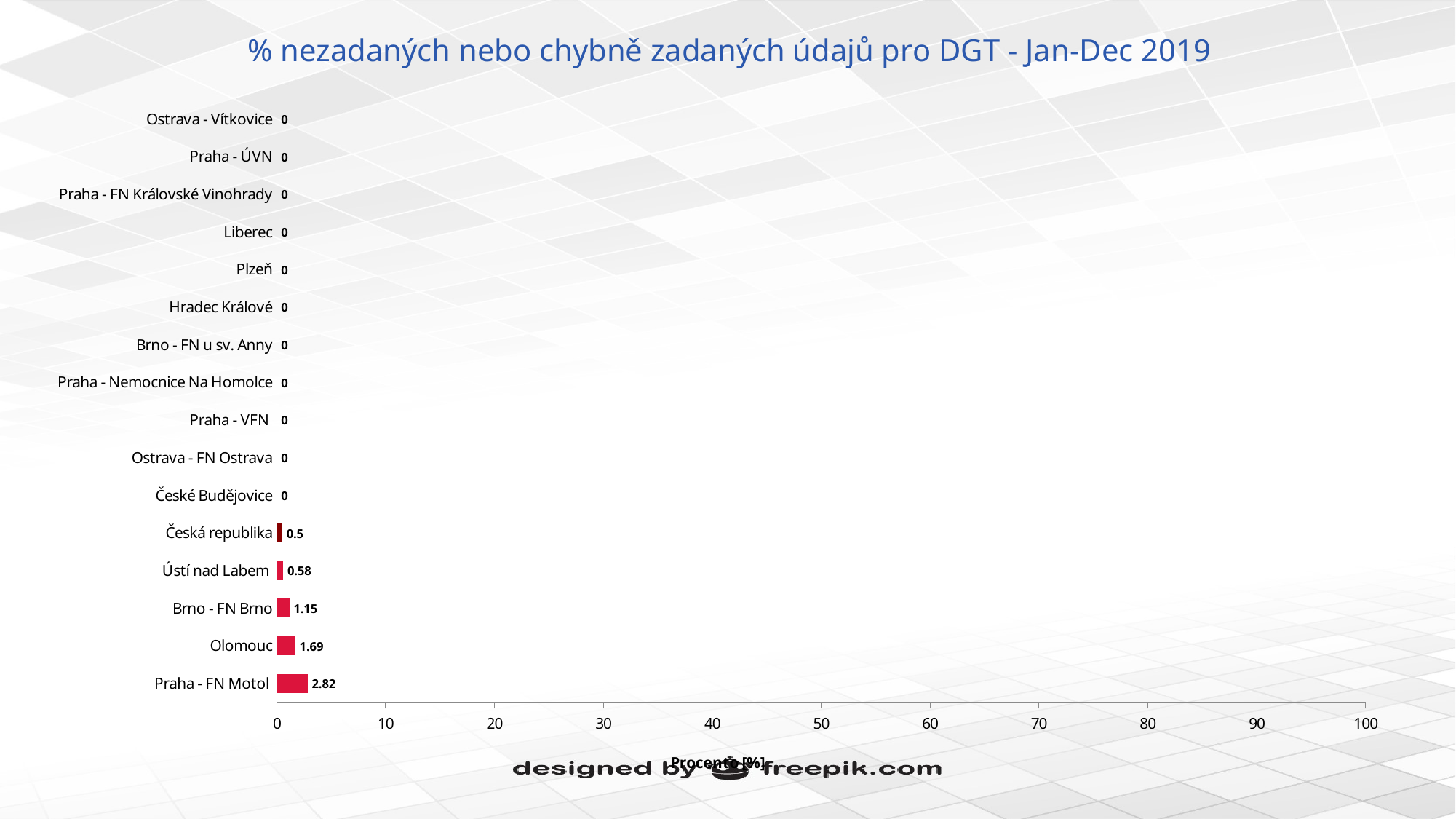
Is the value for Praha - FN Motol greater or less than 10? less What is the value for Brno - FN Brno? 1.15 Which is larger, the value for Brno - FN Brno or the value for Ústí nad Labem? Brno - FN Brno What is the difference between the values for Praha - FN Motol and Olomouc? 1.13 What is the value for Ústí nad Labem? 0.58 Which category has the highest value? Praha - FN Motol What is the value for Česká republika? 0.5 What kind of chart is shown on the slide? bar chart What is the title of the chart? % nezadaných nebo chybně zadaných údajů pro DGT - Jan-Dec 2019 How many categories are shown on the chart? 16 What is the value for Olomouc? 1.69 What is the value for Praha - FN Motol? 2.82